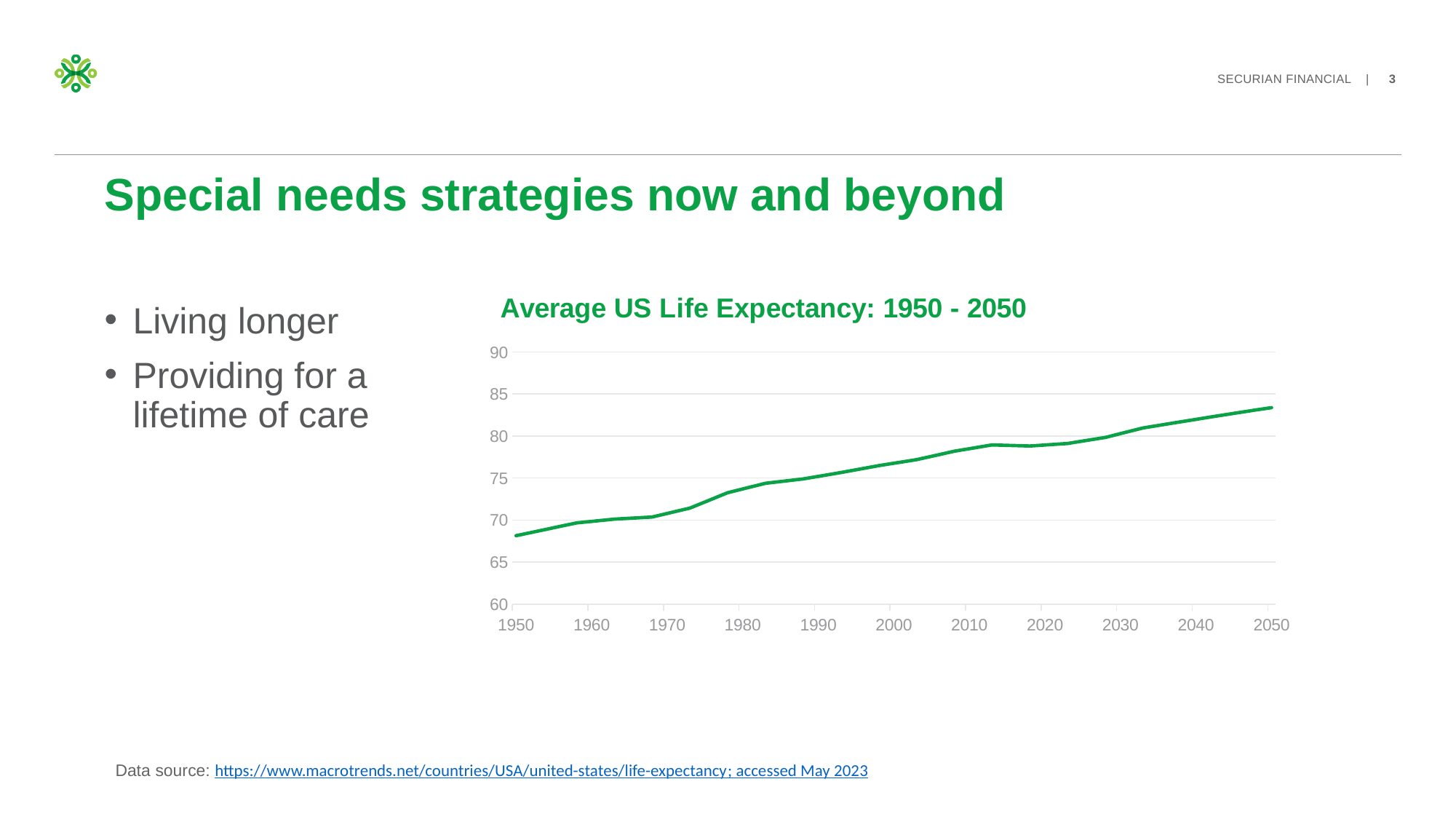
What kind of chart is shown on the slide? line chart Is the value for 2040 greater or less than 80? greater Is the value for 2000 greater or less than 75? greater Is the value for 1980 greater or less than 75? less What is the title of the chart? Average US Life Expectancy: 1950 - 2050 Which year on the x axis has the highest life expectancy? 2050 Do the values in the chart rise or fall from 1950 to 2050? rise Which year on the x axis has the lowest life expectancy? 1950 Which is larger, the value for 1970 or the value for 2020? 2020 How many year labels are shown on the x axis? 11